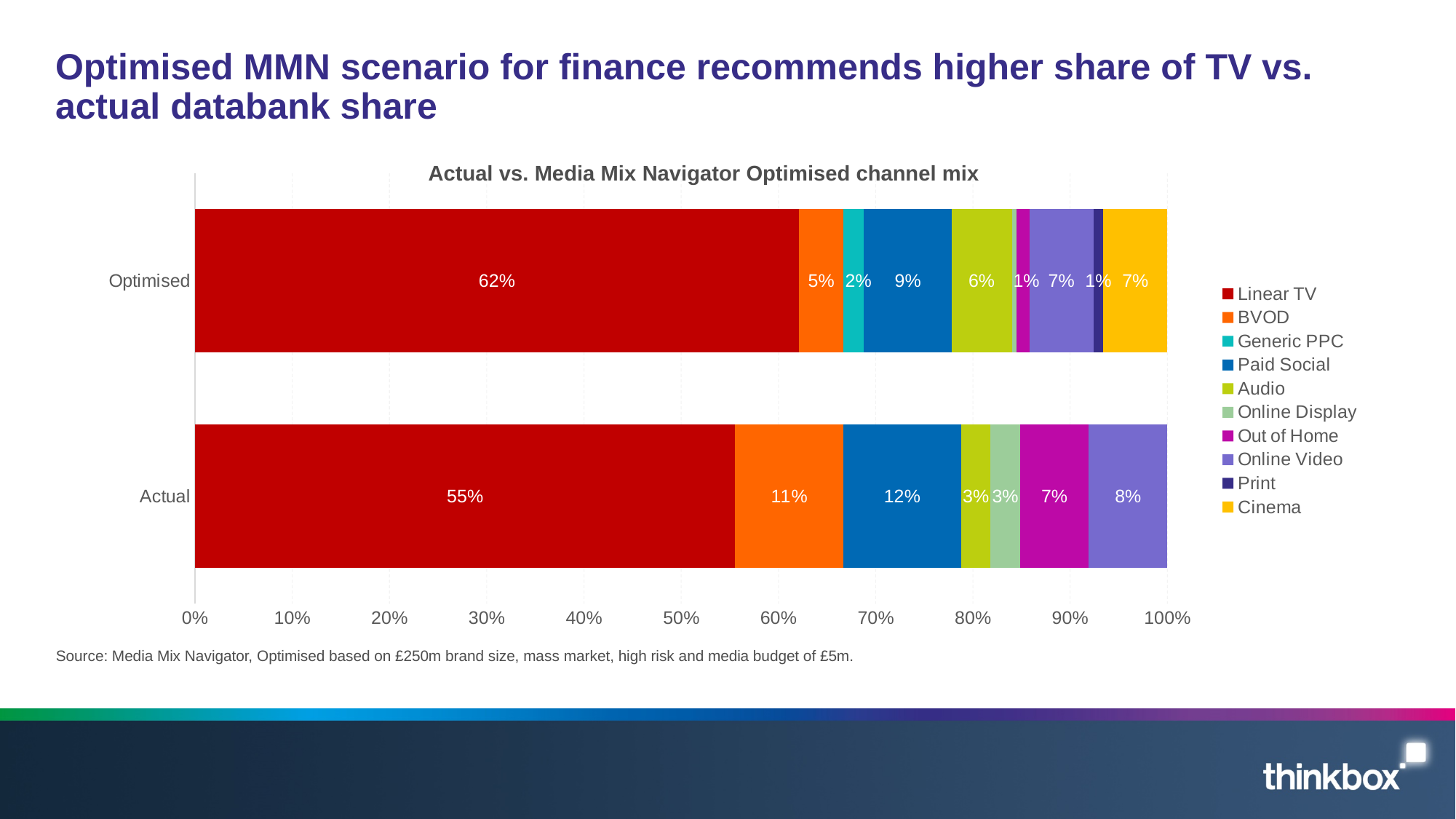
What is the BVOD share in the Optimised bar? 5% Which channel has the largest share in the Actual bar? Linear TV What is the Cinema share in the Optimised bar? 7% What is the title of the chart? Actual vs. Media Mix Navigator Optimised channel mix How many bars (categories) are plotted in the chart? 2 By how many percentage points is the Linear TV share higher in the Optimised bar than in the Actual bar? 7 percentage points What is the Paid Social share in the Actual bar? 12% How many series does the legend list? 10 What is the Linear TV share in the Optimised bar? 62% Is the BVOD share larger in the Optimised bar or the Actual bar? Actual What is the Linear TV share in the Actual bar? 55% What kind of chart is shown on the slide? Stacked bar chart